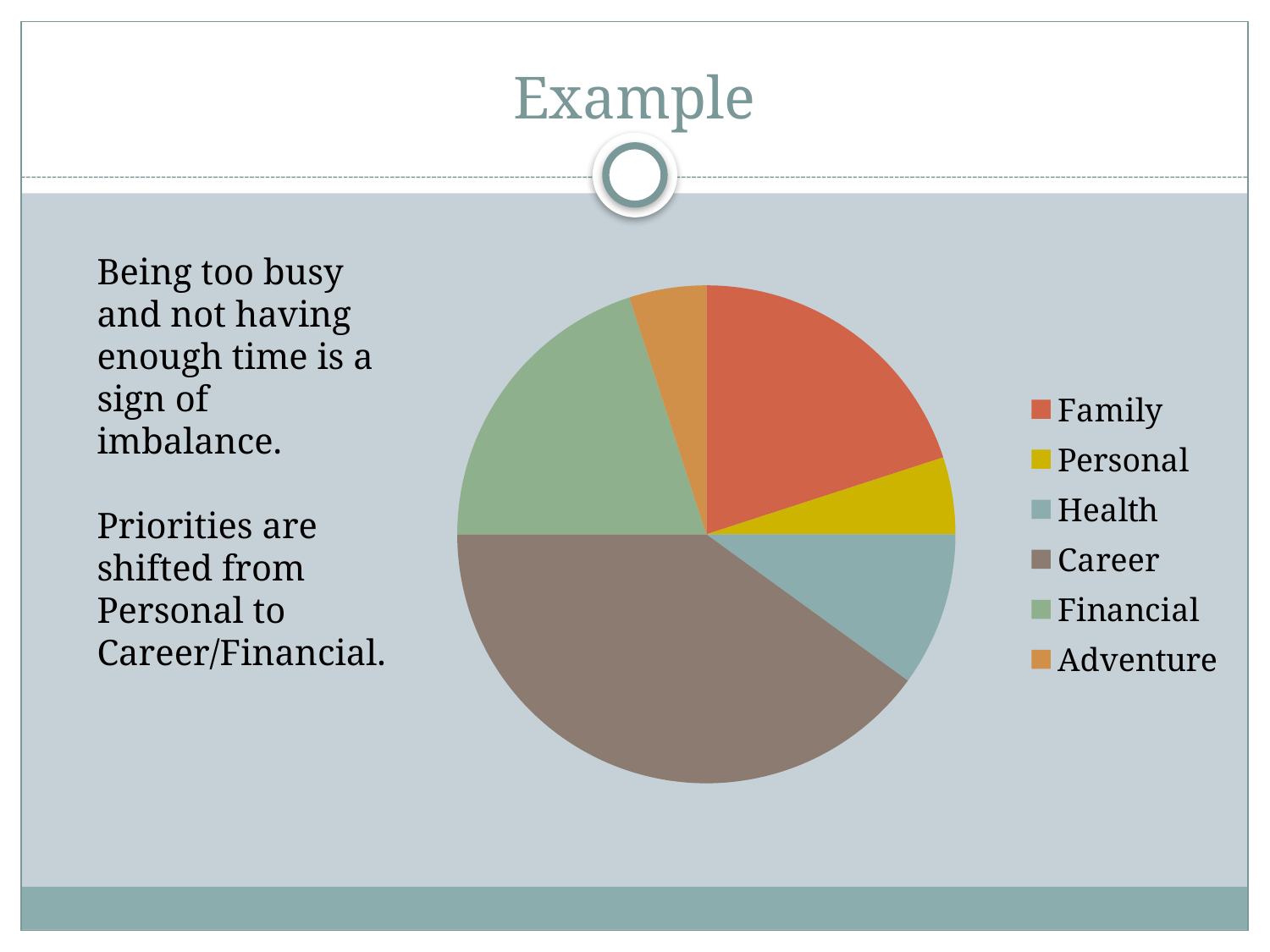
Which slice is larger in the pie chart, Financial or Health? Financial Which slice is larger in the pie chart, Family or Health? Family Which category has the largest slice of the pie chart? Career Which category is listed first in the pie chart's legend? Family What colour is the Career slice in the pie chart? brown Which slice is larger in the pie chart, Career or Financial? Career How many categories does the pie chart have? 6 What kind of chart is shown on the slide? pie chart How many entries does the legend of the pie chart list? 6